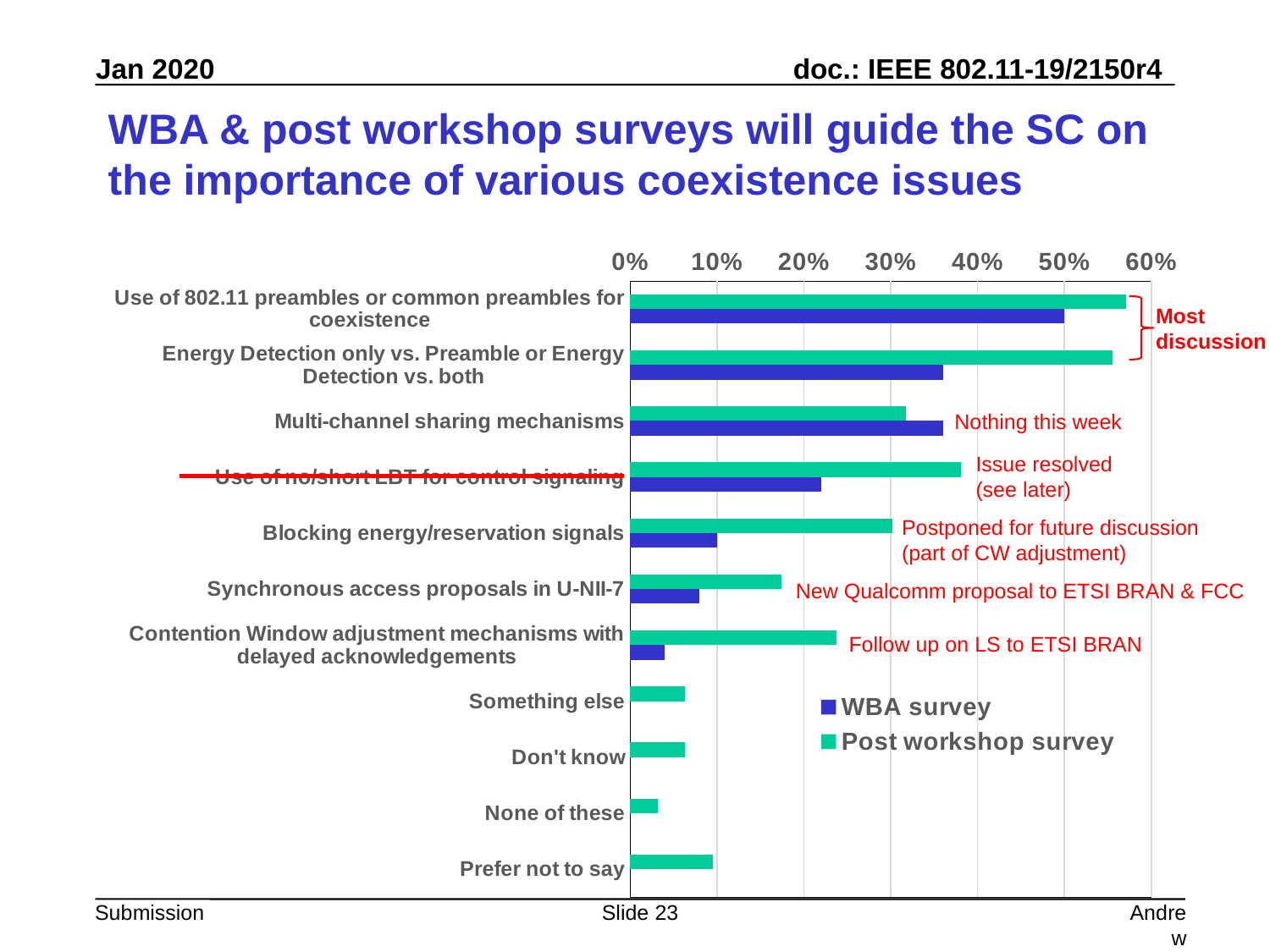
Is the WBA survey value for Blocking energy/reservation signals greater or less than 20%? less Which category has the highest value in the Post workshop survey series? Use of 802.11 preambles or common preambles for coexistence What kind of chart is shown on the slide? bar chart Is the Post workshop survey value for Energy Detection only vs. Preamble or Energy Detection vs. both greater or less than 50%? greater What is the highest percentage tick shown on the chart's axis? 60% Is the Post workshop survey value for Contention Window adjustment mechanisms with delayed acknowledgements greater or less than 20%? greater Which colour represents the WBA survey series in the chart? blue For Use of no/short LBT for control signaling, which series has the larger value, WBA survey or Post workshop survey? Post workshop survey Which category has the lowest value in the Post workshop survey series? None of these How many series does the chart legend list? 2 How many categories are plotted on the chart? 11 For Multi-channel sharing mechanisms, which series has the larger value, WBA survey or Post workshop survey? WBA survey